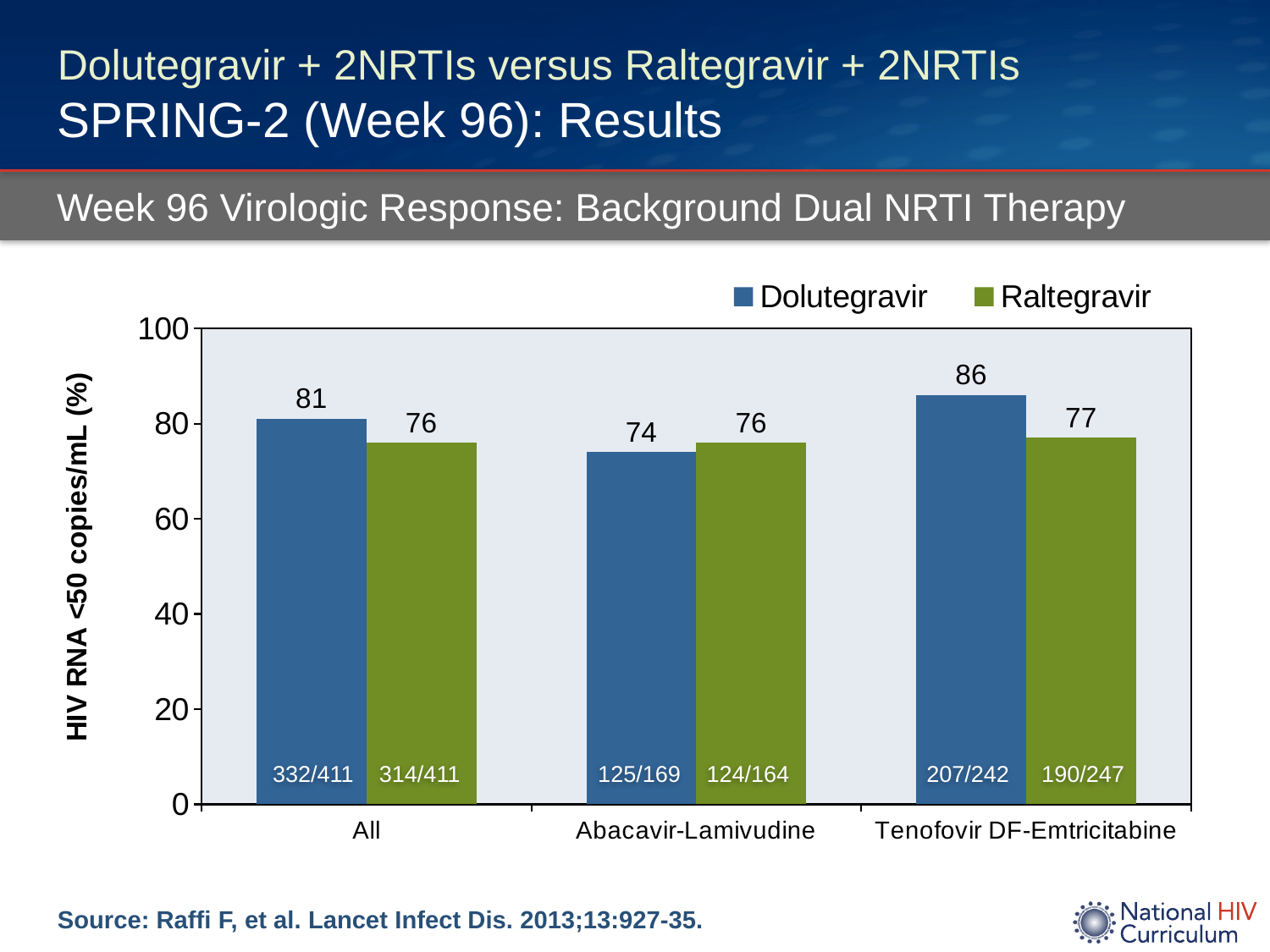
In the Abacavir-Lamivudine group, which is larger, the Dolutegravir value or the Raltegravir value? Raltegravir What is the Raltegravir value for the Abacavir-Lamivudine group? 76 What is the difference between the Dolutegravir and Raltegravir values for the Tenofovir DF-Emtricitabine group? 9 What kind of chart is shown on the slide? Bar chart What is the Dolutegravir value for the Tenofovir DF-Emtricitabine group? 86 What is the Dolutegravir value for the All group? 81 What is the Raltegravir value for the Tenofovir DF-Emtricitabine group? 77 How many series does the legend list? 2 Which category has the lowest Dolutegravir value? Abacavir-Lamivudine How many categories are shown on the x axis? 3 What is the difference between the Dolutegravir and Raltegravir values for the All group? 5 Which category has the highest Dolutegravir value? Tenofovir DF-Emtricitabine